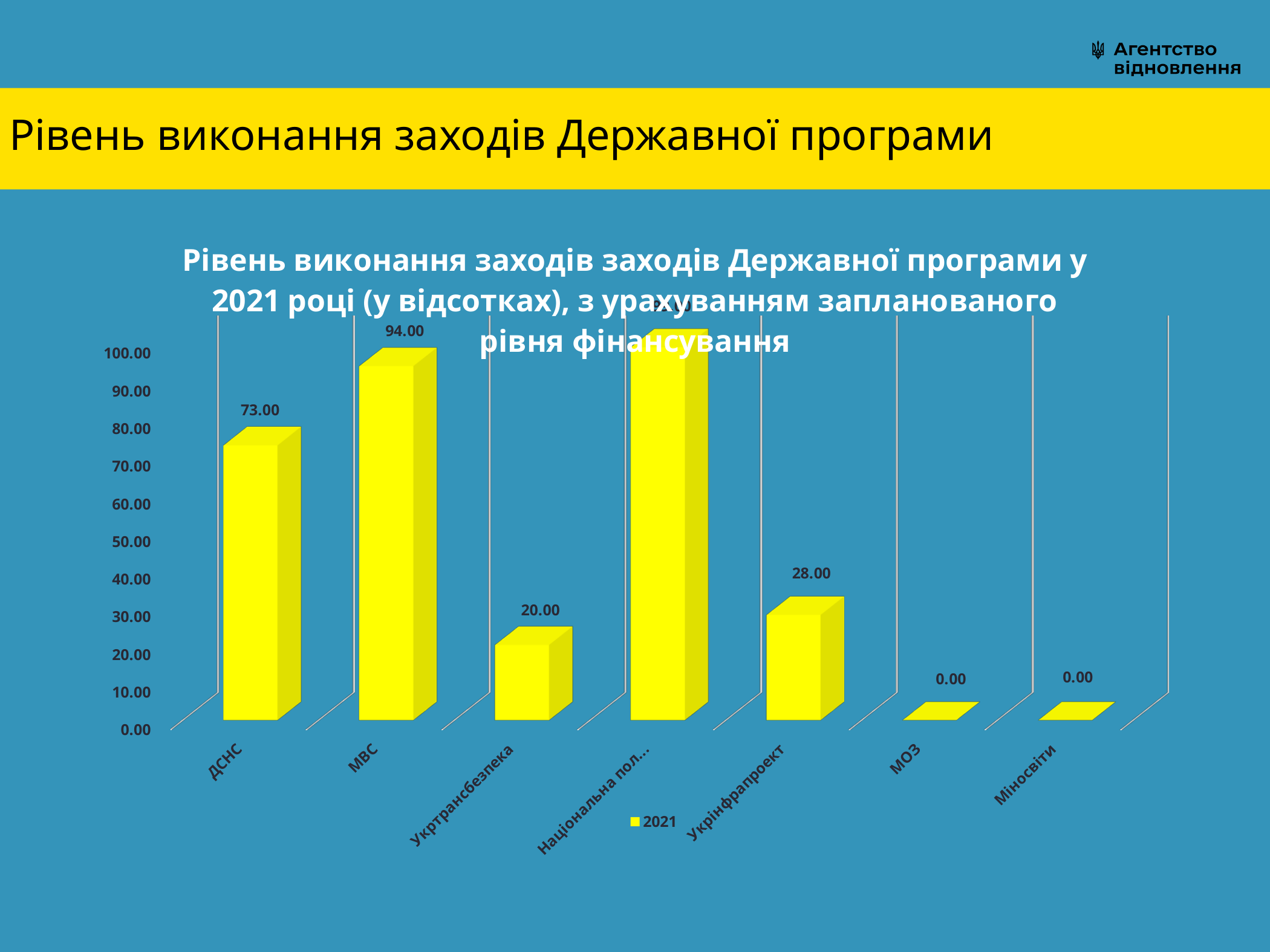
How many categories are shown on the x axis? 7 What is the value for Укртрансбезпека? 20.00 What kind of chart is shown on the slide? bar chart What is the legend entry shown below the chart? 2021 What is the value for ДСНС? 73.00 How many series does the legend list? 1 What is the value for МОЗ? 0.00 What is the difference between the values for МВС and ДСНС? 21.00 What is the value for Укрінфрапроект? 28.00 Is the value for ДСНС greater or less than 50? greater What is the value for МВС? 94.00 Which has a larger value, Укрінфрапроект or Укртрансбезпека? Укрінфрапроект